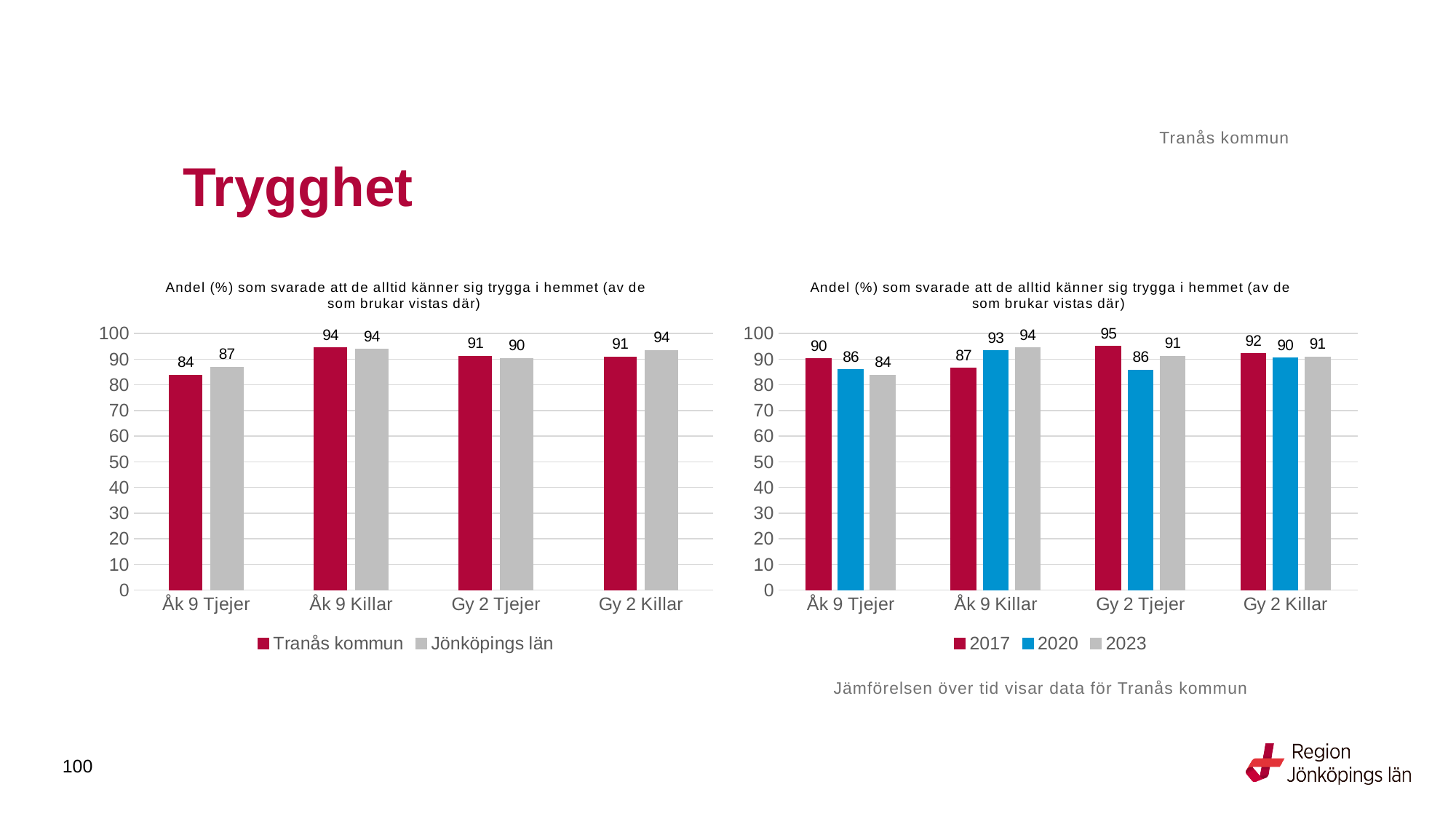
In the right chart, what is the difference between the 2017 and 2020 values for Gy 2 Tjejer? 9 In the left chart, which category has the lowest value for Tranås kommun? Åk 9 Tjejer In the right chart, which year has the highest value for Gy 2 Tjejer? 2017 In the right chart, what is the value for 2020 for Åk 9 Killar? 93 In the right chart, how many categories are shown on the x axis? 4 In the right chart, is the 2017 value for Åk 9 Tjejer larger or the 2023 value for Åk 9 Tjejer? 2017 In the left chart, what is the value for Jönköpings län for Gy 2 Killar? 94 In the right chart, what is the value for 2017 for Gy 2 Tjejer? 95 In the left chart, what is the value for Tranås kommun for Åk 9 Tjejer? 84 What kind of chart is the right chart? Bar chart In the left chart, what is the difference between Jönköpings län and Tranås kommun for Åk 9 Tjejer? 3 In the left chart, how many series does the legend list? 2